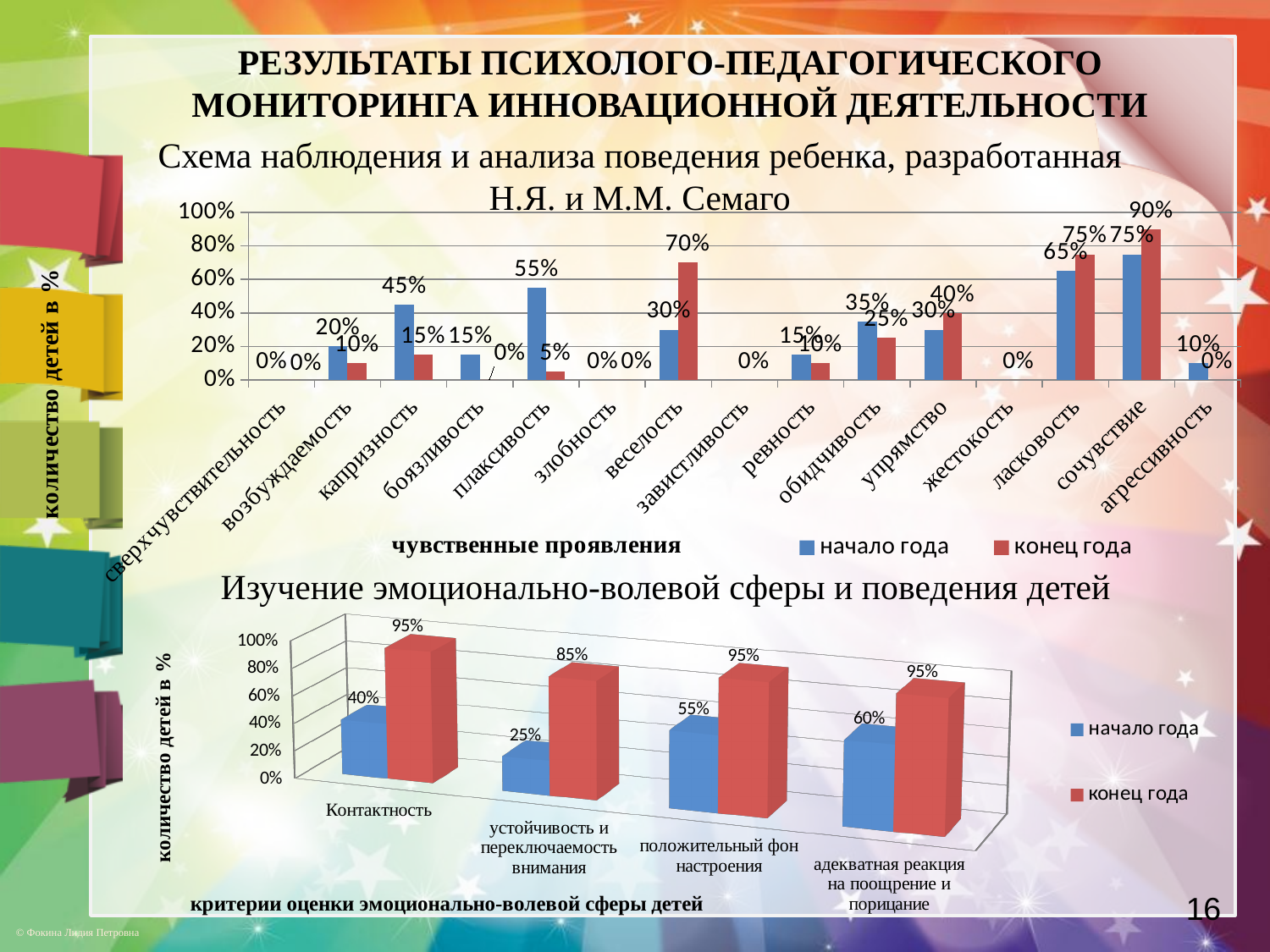
In the top chart (чувственные проявления), what is the value for веселость at конец года? 70% In the top chart (чувственные проявления), what is the difference between the начало года and конец года values for капризность? 30% In the top chart (чувственные проявления), what is the value for плаксивость at начало года? 55% In the top chart (чувственные проявления), how many series does the legend list? 2 In the top chart (чувственные проявления), which is larger for упрямство: начало года or конец года? конец года What type of chart is the bottom chart (критерии оценки эмоционально-волевой сферы детей)? bar chart In the bottom chart (критерии оценки эмоционально-волевой сферы детей), what is the value for устойчивость и переключаемость внимания at начало года? 25% In the bottom chart (критерии оценки эмоционально-волевой сферы детей), how many categories are shown? 4 In the bottom chart (критерии оценки эмоционально-волевой сферы детей), what is the difference between конец года and начало года for Контактность? 55% In the top chart (чувственные проявления), what is the value for ласковость at начало года? 65% In the bottom chart (критерии оценки эмоционально-волевой сферы детей), which category has the lowest value for конец года? устойчивость и переключаемость внимания In the top chart (чувственные проявления), which category has the highest value for конец года? сочувствие